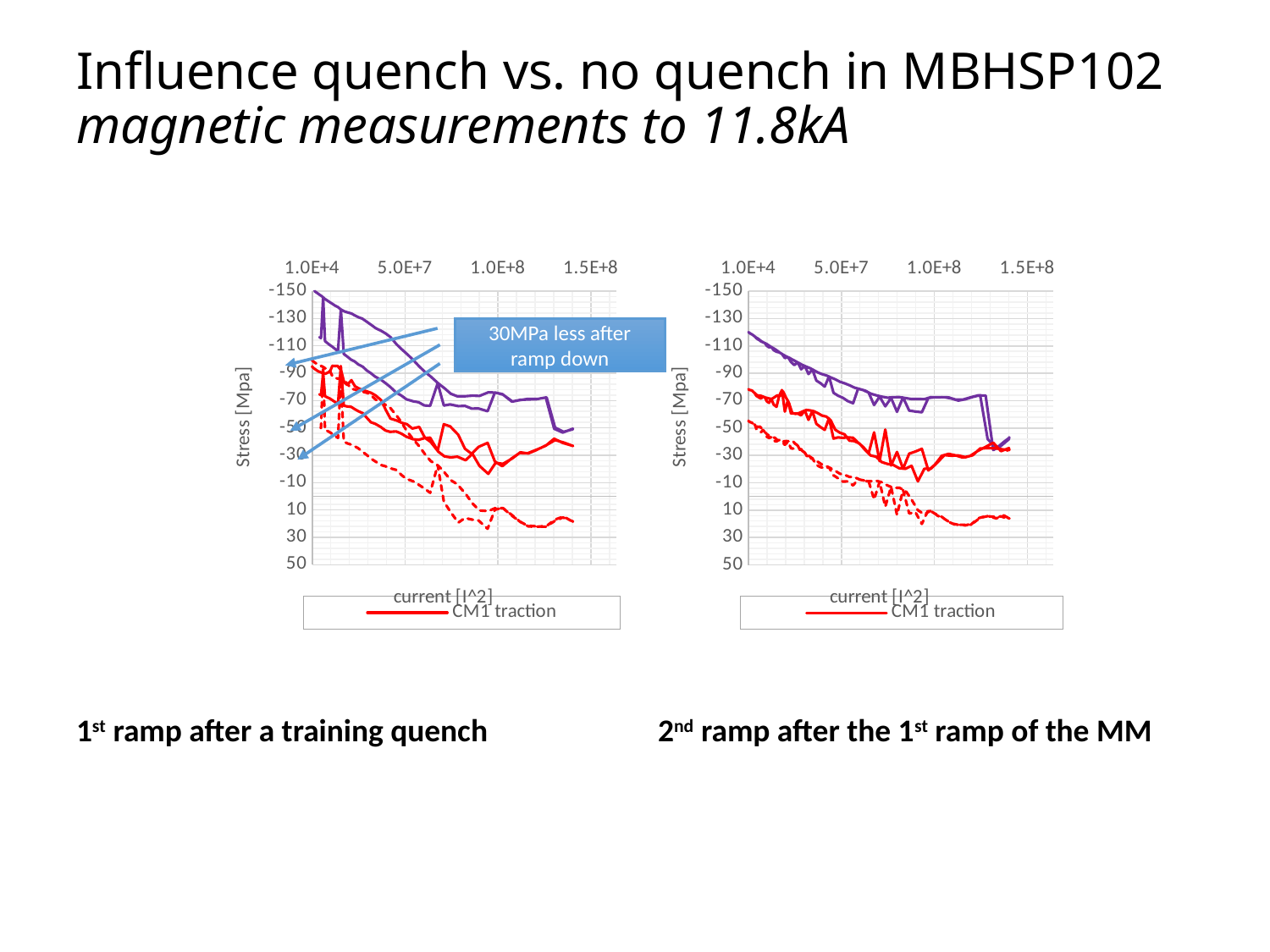
In the right chart, is the value of the red dashed line at its right-hand end greater or less than 10? greater In the right chart, what series name is shown in the legend? CM1 traction In the left chart, is the value of the purple line at the left-hand start (1.0E+4) greater or less than -130? less In the left chart, what is the label of the vertical axis? Stress [Mpa] In the left chart, is the value of the red dashed line at its right-hand end greater or less than 10? greater In the left chart, do the stress values of the purple line become more negative or less negative as current increases from 1.0E+4 to 1.0E+8? less negative In the right chart, do the stress values of the red dashed line become more negative or less negative as current increases? less negative How many charts are shown on the slide? 2 What type of chart is the left chart (1st ramp after a training quench)? line chart What type of chart is the right chart (2nd ramp after the 1st ramp of the MM)? line chart